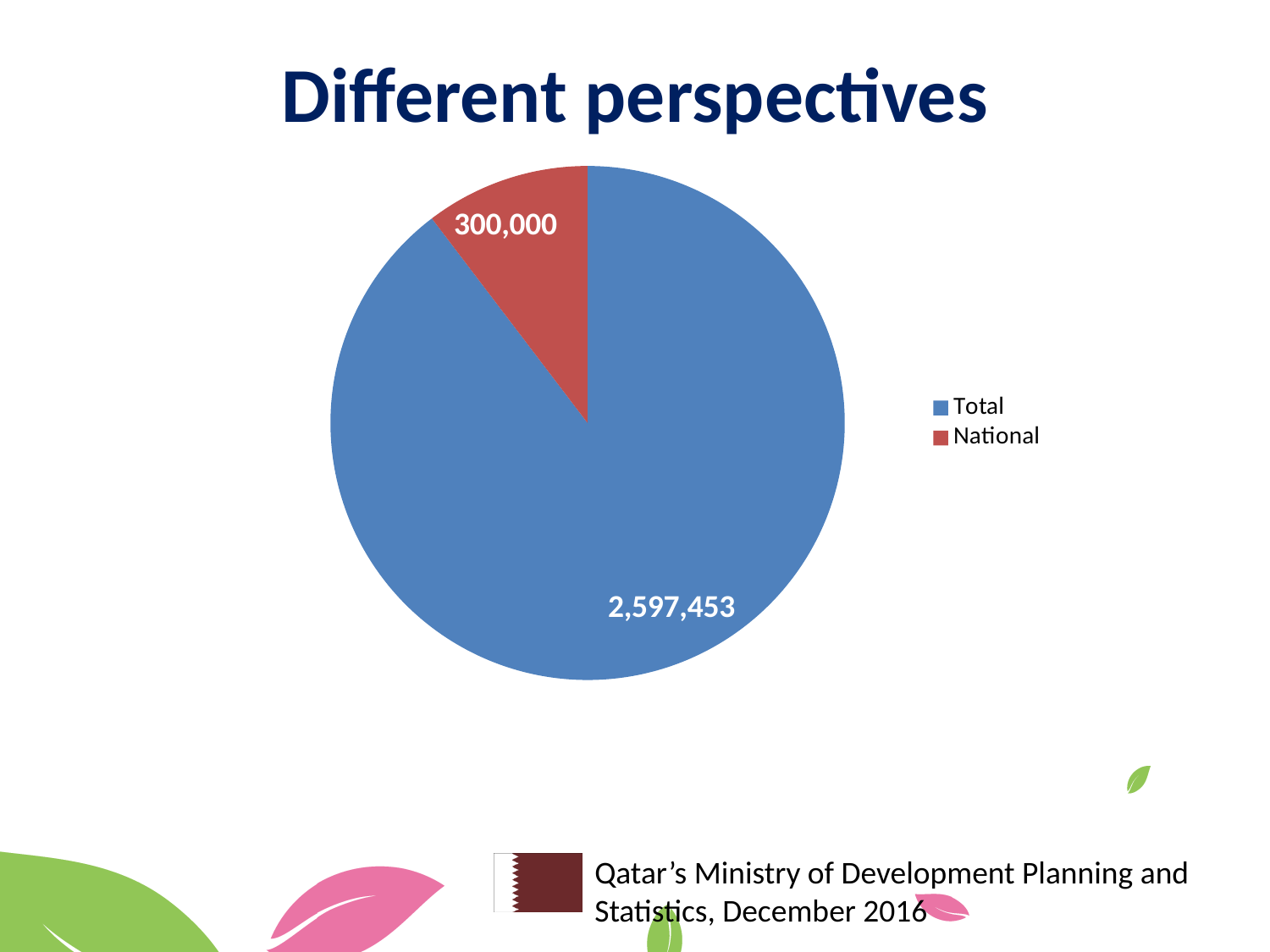
Which is larger, the Total slice or the National slice? Total What is the value of the Total slice? 2,597,453 How many slices does the pie chart have? 2 What is the value of the National slice? 300,000 What is the title of the slide containing the chart? Different perspectives Which slice is the smallest? National What colour is the National slice? red What is the difference between the Total value and the National value? 2,297,453 What kind of chart is shown on the slide? pie chart What is the sum of the two slice values? 2,897,453 Which slice is the largest? Total How many entries does the legend list? 2